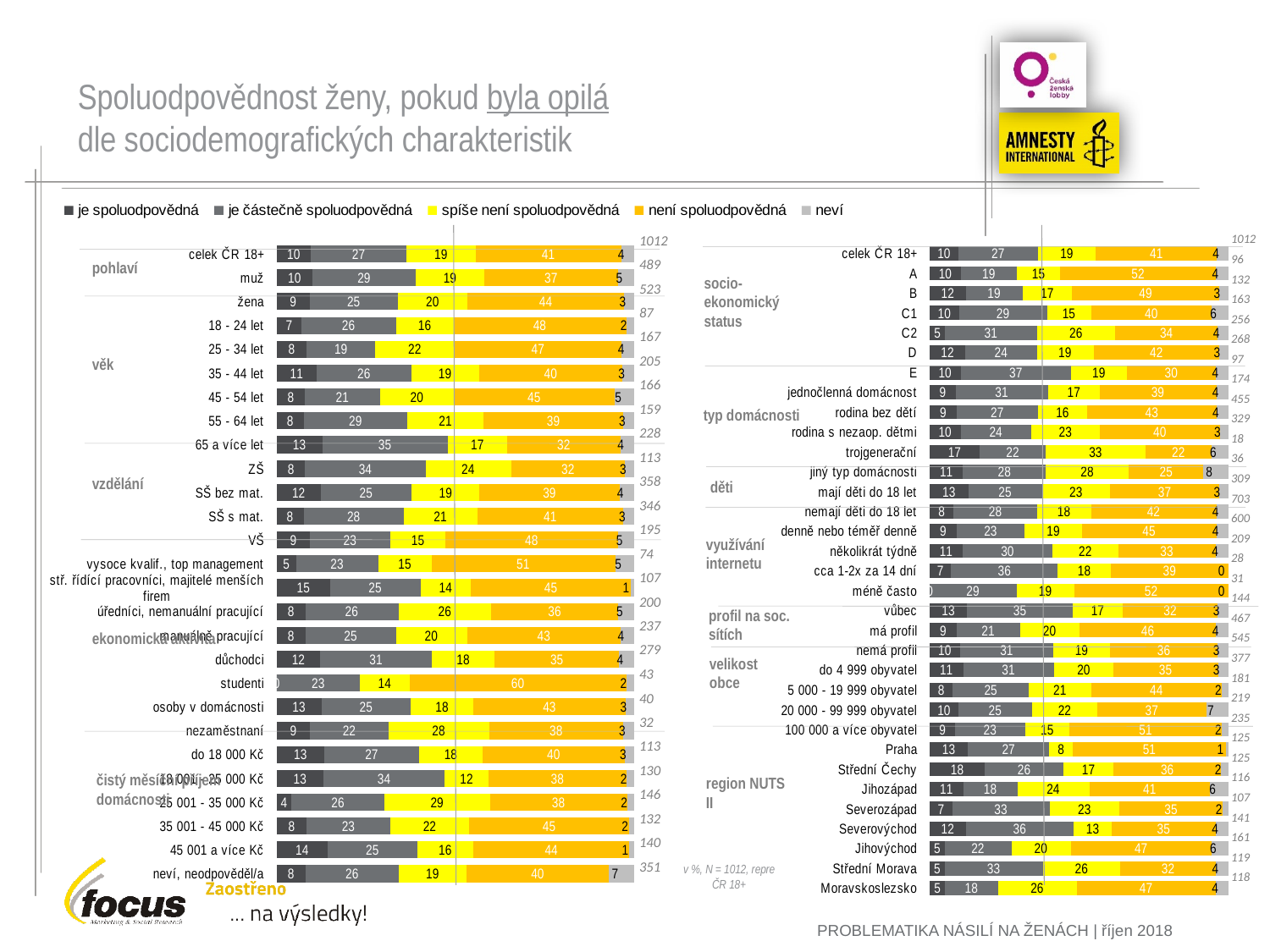
In the left chart, what is the total of the stacked bar for 'muž'? 100 In the right chart, what is the value of 'je částečně spoluodpovědná' for socio-economic status 'E'? 37 In the left chart, what is the value of 'je částečně spoluodpovědná' for 'žena'? 25 In the left chart, what is the value of 'není spoluodpovědná' for 'celek ČR 18+'? 41 In the right chart, what is the value of 'je spoluodpovědná' for 'Střední Čechy'? 18 What kind of chart is shown on the left side of the slide? Stacked bar chart In the right chart, what is the value of 'není spoluodpovědná' for 'Praha'? 51 How many series does the legend list? 5 In the left chart, what is the difference between the 'není spoluodpovědná' values for 'muž' and 'žena'? 7 In the left chart, which category has the highest value for 'není spoluodpovědná'? studenti What is the first legend entry of the chart? je spoluodpovědná In the right chart, which is larger for 'není spoluodpovědná': 'A' or 'C2'? A